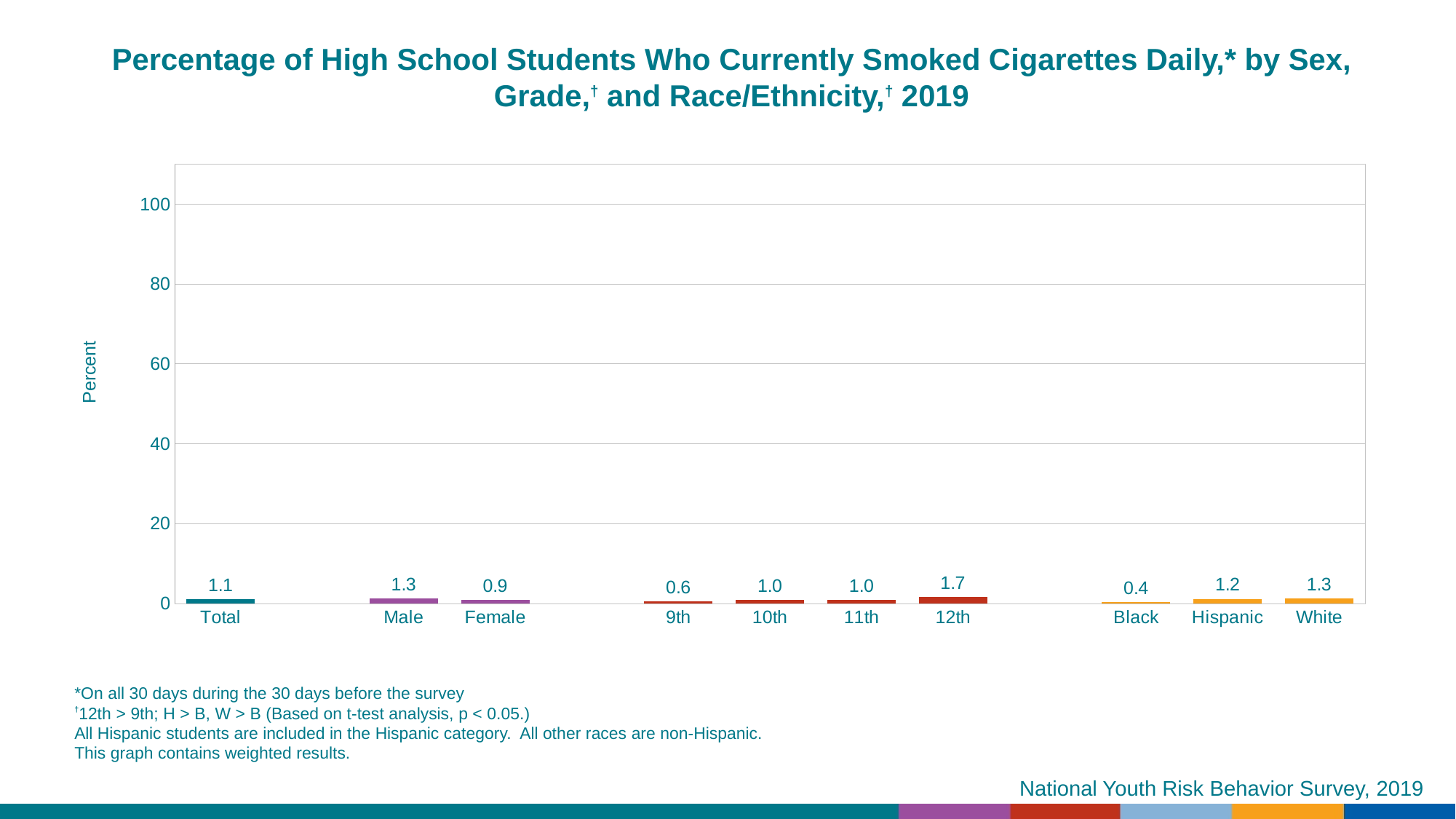
Is the value for Male greater or less than 20? less Which category has the highest value? 12th Which category has the lowest value? Black What is the value for Black students? 0.4 What is the difference between the values for 12th and 9th grade? 1.1 What is the difference between the values for Male and Female? 0.4 What percentage of 12th grade students currently smoked cigarettes daily? 1.7 What is the value for Total? 1.1 What kind of chart is this? bar chart Which is larger, the value for Hispanic or the value for White? White How many categories are shown on the x axis? 10 What is the label on the y axis? Percent